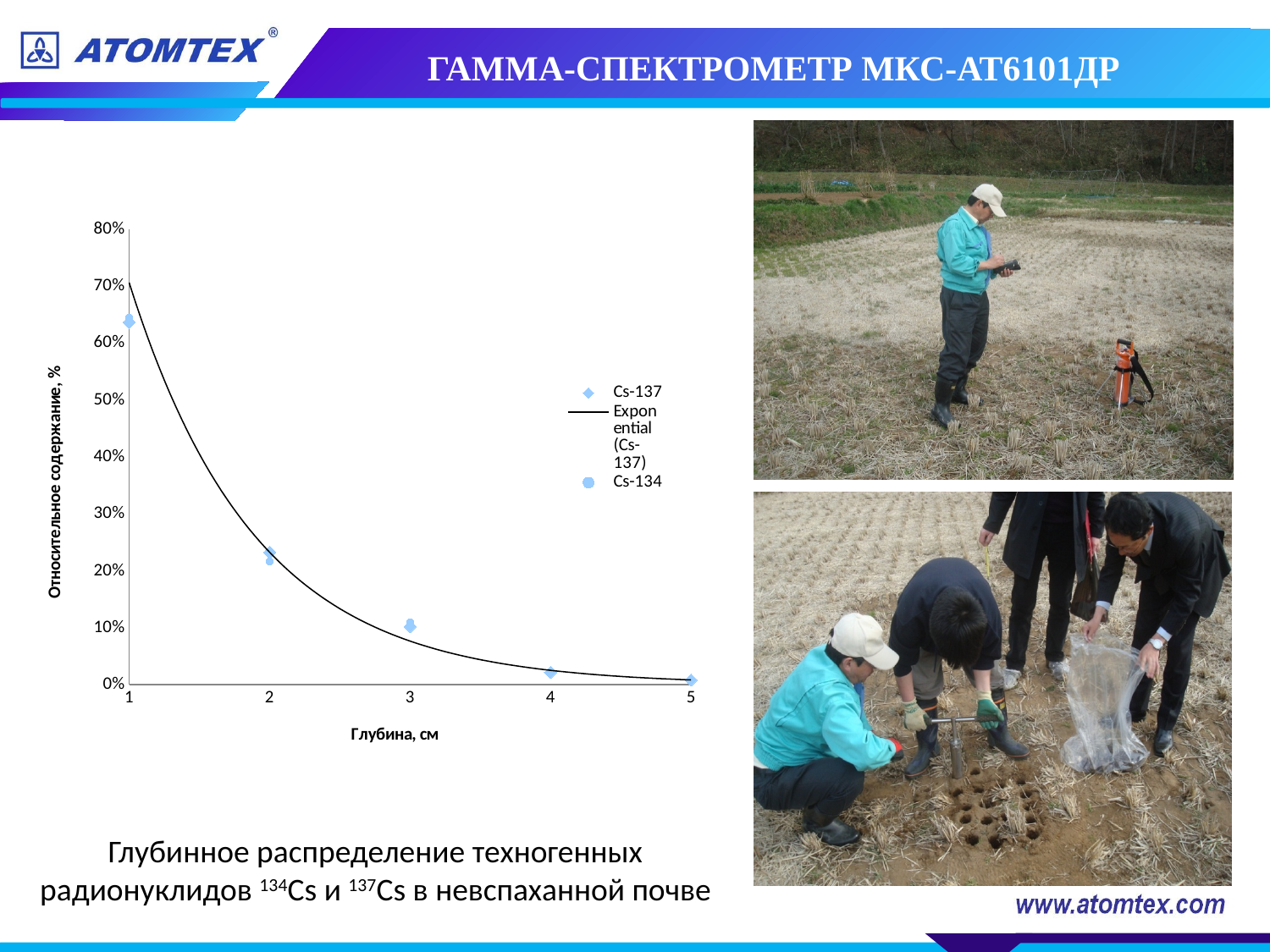
Is the Cs-137 value at depth 1 cm greater or less than 60%? greater Is the Cs-134 value at depth 4 cm greater or less than 10%? less What kind of chart is shown on the slide? scatter chart At which depth is the relative content of Cs-137 highest? 1 Which is larger, the Cs-137 value at depth 1 cm or at depth 3 cm? depth 1 cm What is the title of the y axis of the chart? Относительное содержание, % What is the title of the x axis of the chart? Глубина, см How many entries does the chart legend list? 3 Is the Cs-137 value at depth 2 cm greater or less than 30%? less Do the Cs-137 values rise or fall as depth increases along the x axis? fall At which depth is the relative content of Cs-137 lowest? 5 How many depth values are plotted along the x axis? 5